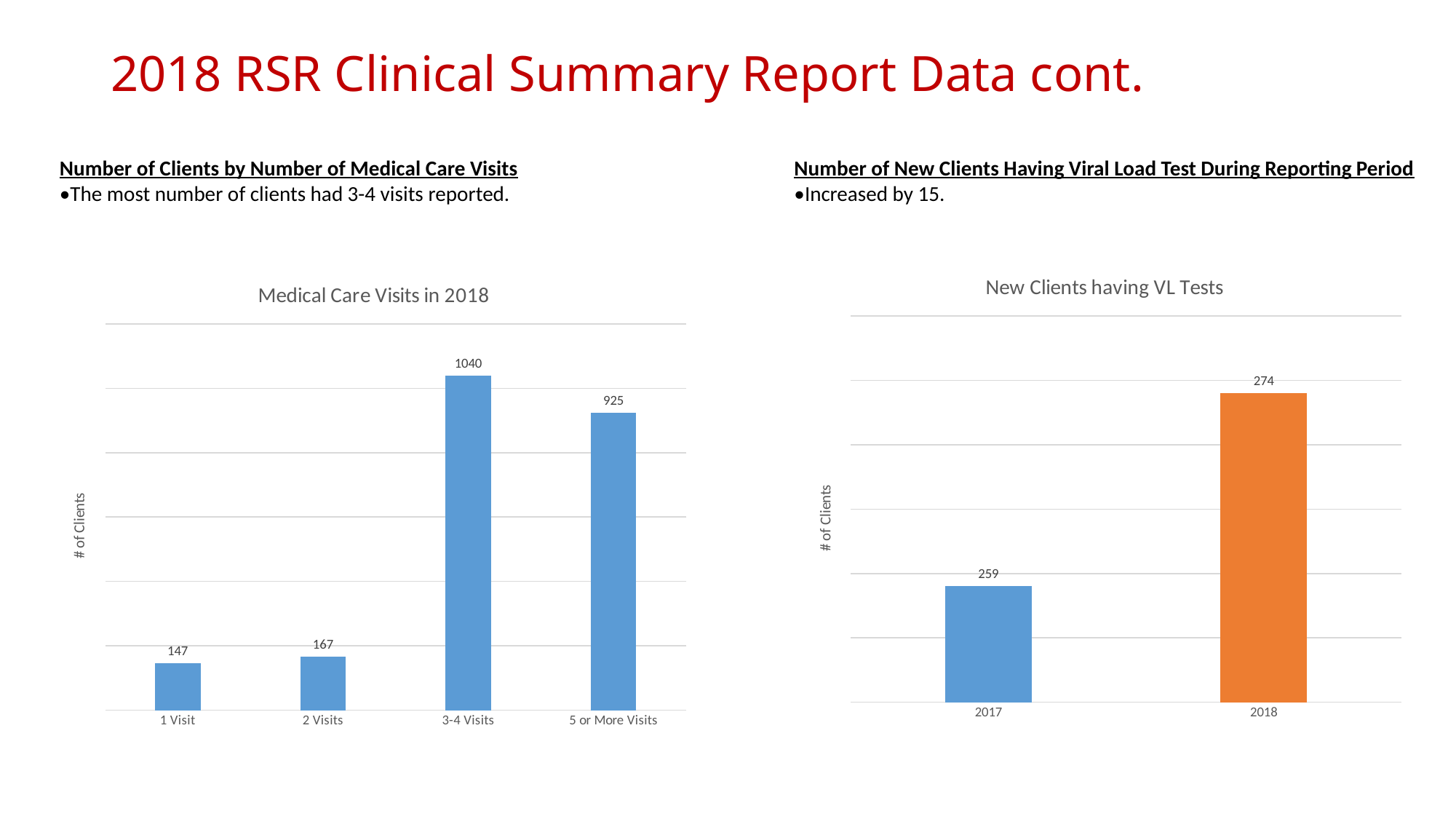
In the 'New Clients having VL Tests' chart, what is the difference between the 2018 and 2017 values? 15 In the 'New Clients having VL Tests' chart, what is the value for 2018? 274 In the 'Medical Care Visits in 2018' chart, which is larger: the value for 2 Visits or the value for 1 Visit? 2 Visits In the 'Medical Care Visits in 2018' chart, what is the difference between the values for 3-4 Visits and 5 or More Visits? 115 In the 'New Clients having VL Tests' chart, what is the label on the vertical axis? # of Clients How many categories are shown in the 'Medical Care Visits in 2018' chart? 4 What type of chart is 'Medical Care Visits in 2018'? Bar chart In the 'Medical Care Visits in 2018' chart, how many clients had 3-4 visits? 1040 In the 'Medical Care Visits in 2018' chart, which category has the lowest number of clients? 1 Visit In the 'New Clients having VL Tests' chart, what is the value for 2017? 259 In the 'Medical Care Visits in 2018' chart, what is the value for 1 Visit? 147 In the 'Medical Care Visits in 2018' chart, which category has the highest number of clients? 3-4 Visits